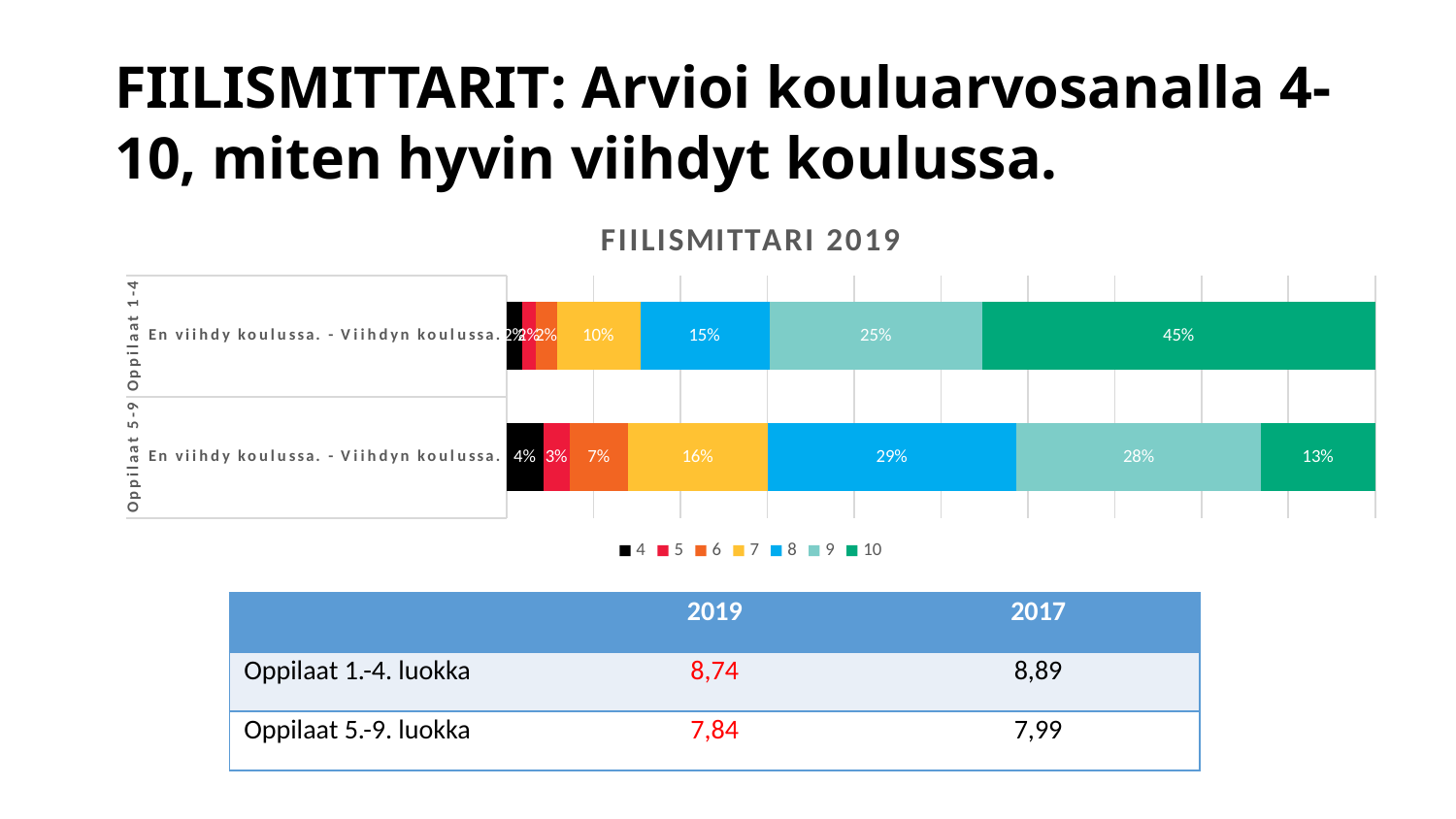
Which grade has the largest share for Oppilaat 5-9? 8 What share of Oppilaat 5-9 gave the grade 10? 13% What share of Oppilaat 1-4 gave the grade 10? 45% What is the difference between the share of grade 10 for Oppilaat 1-4 and for Oppilaat 5-9? 32 percentage points Which grade has the largest share for Oppilaat 1-4? 10 What share of Oppilaat 1-4 gave the grade 9? 25% What share of Oppilaat 5-9 gave the grade 8? 29% What kind of chart is shown on the slide? Stacked bar chart What is the title of the chart? FIILISMITTARI 2019 Which group has the larger share of grade 7, Oppilaat 1-4 or Oppilaat 5-9? Oppilaat 5-9 How many series does the chart legend list? 7 How many category bars are plotted in the chart? 2